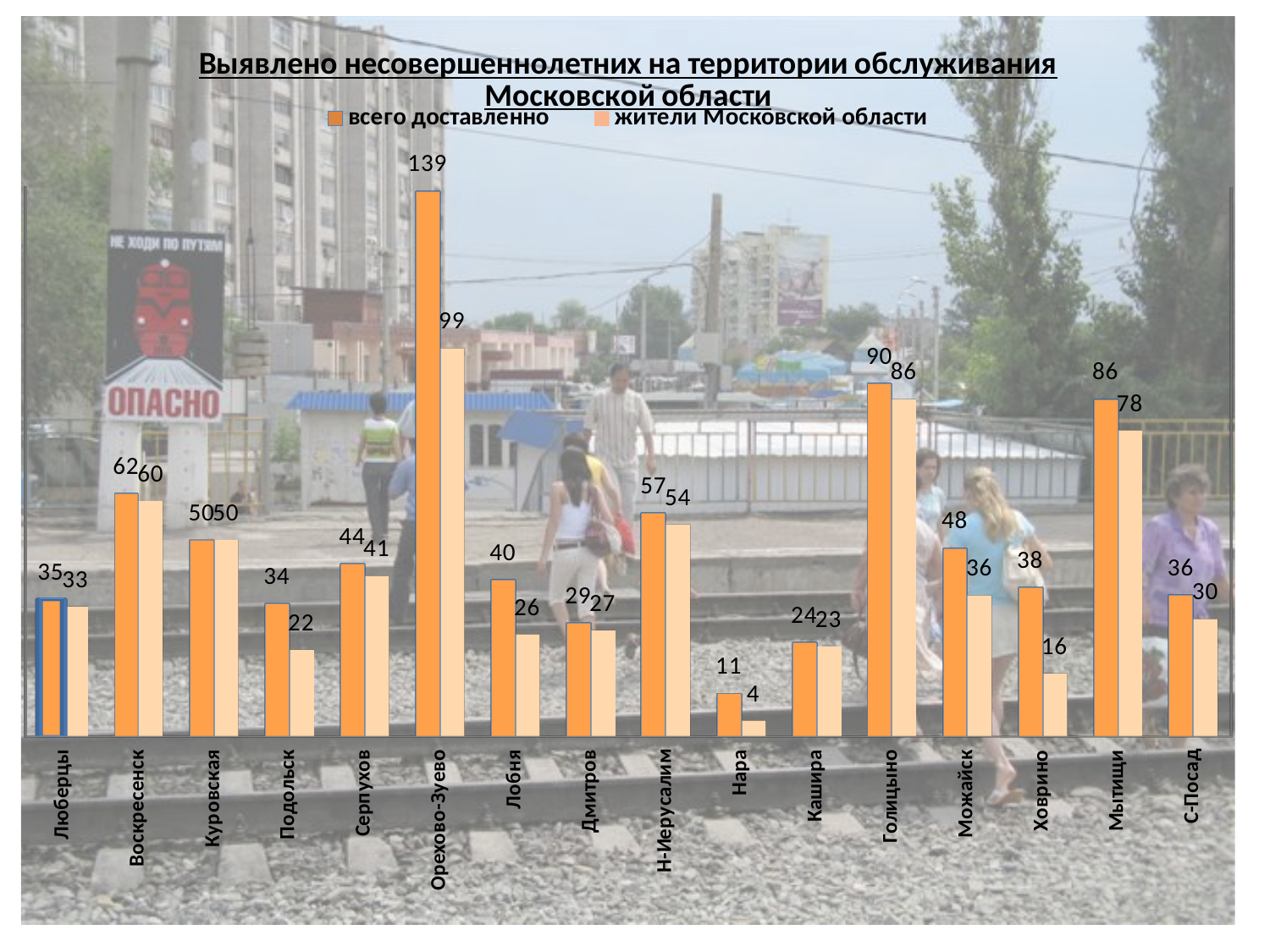
Which is larger: 'всего доставленно' for Лобня or for Дмитров? Лобня What is the title of the chart? Выявлено несовершеннолетних на территории обслуживания Московской области How many categories are shown on the x axis? 16 Which category has the highest value for 'всего доставленно'? Орехово-Зуево How many series does the legend list? 2 What is the difference between 'всего доставленно' for Мытищи and for Можайск? 38 What is the difference between 'всего доставленно' and 'жители Московской области' for Орехово-Зуево? 40 Which category has the lowest value for 'жители Московской области'? Нара What is the value of 'всего доставленно' for Ховрино? 38 What is the value of 'всего доставленно' for Орехово-Зуево? 139 What is the value of 'жители Московской области' for Голицыно? 86 What kind of chart is shown on the slide? Bar chart